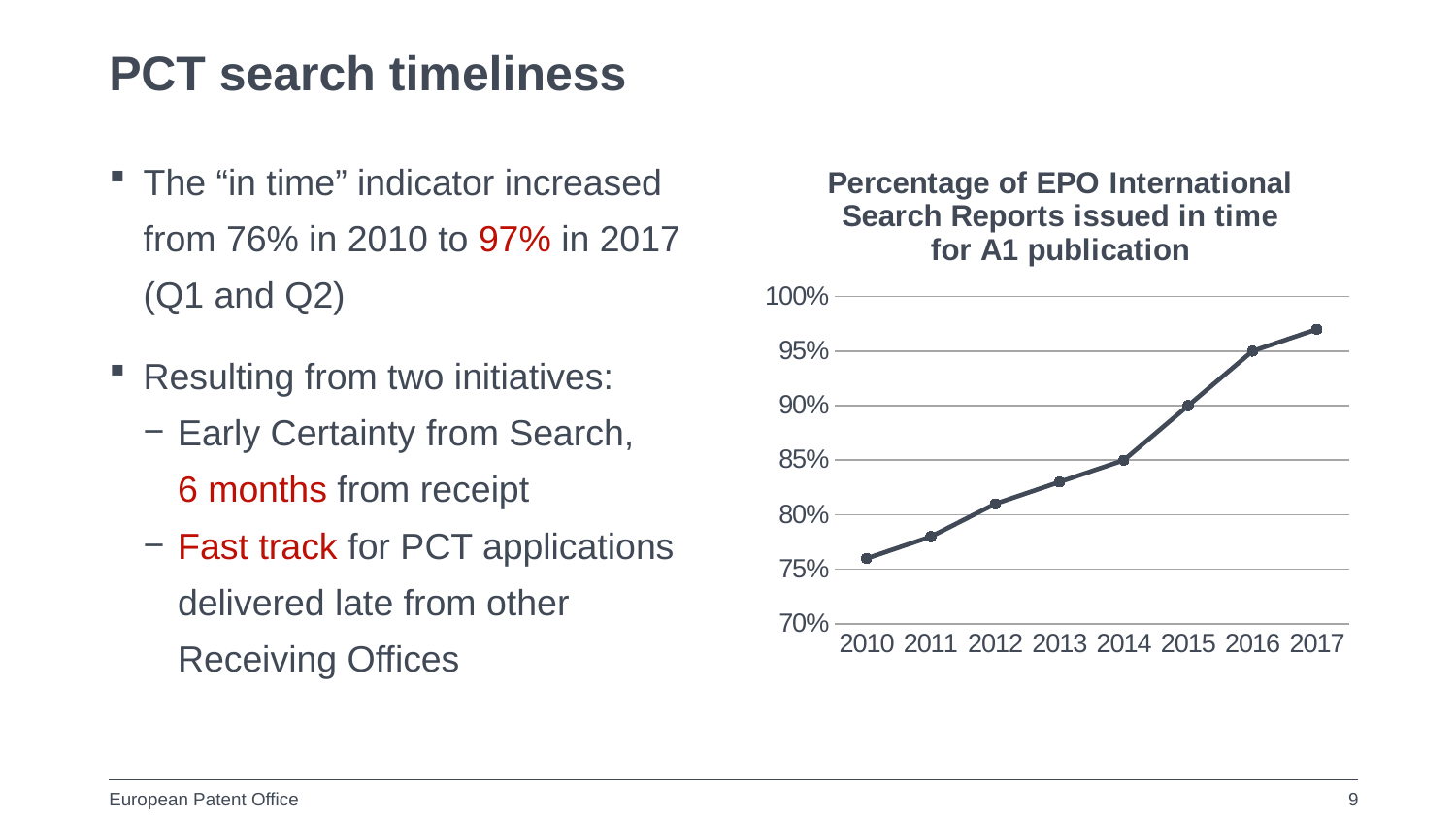
What kind of chart is shown on the slide? line chart What is the title of the chart? Percentage of EPO International Search Reports issued in time for A1 publication What is the percentage of search reports issued in time for 2017? 97% Which year has the larger value, 2013 or 2016? 2016 Is the value for 2013 greater or less than 85%? less By how many percentage points did the value increase from 2010 to 2017? 21 Which year has the lowest percentage of search reports issued in time? 2010 Is the value for 2011 greater or less than 80%? less What is the percentage of search reports issued in time for 2010? 76% Which year has the highest percentage of search reports issued in time? 2017 Do the values rise or fall from 2010 to 2017? rise How many years are plotted on the chart? 8